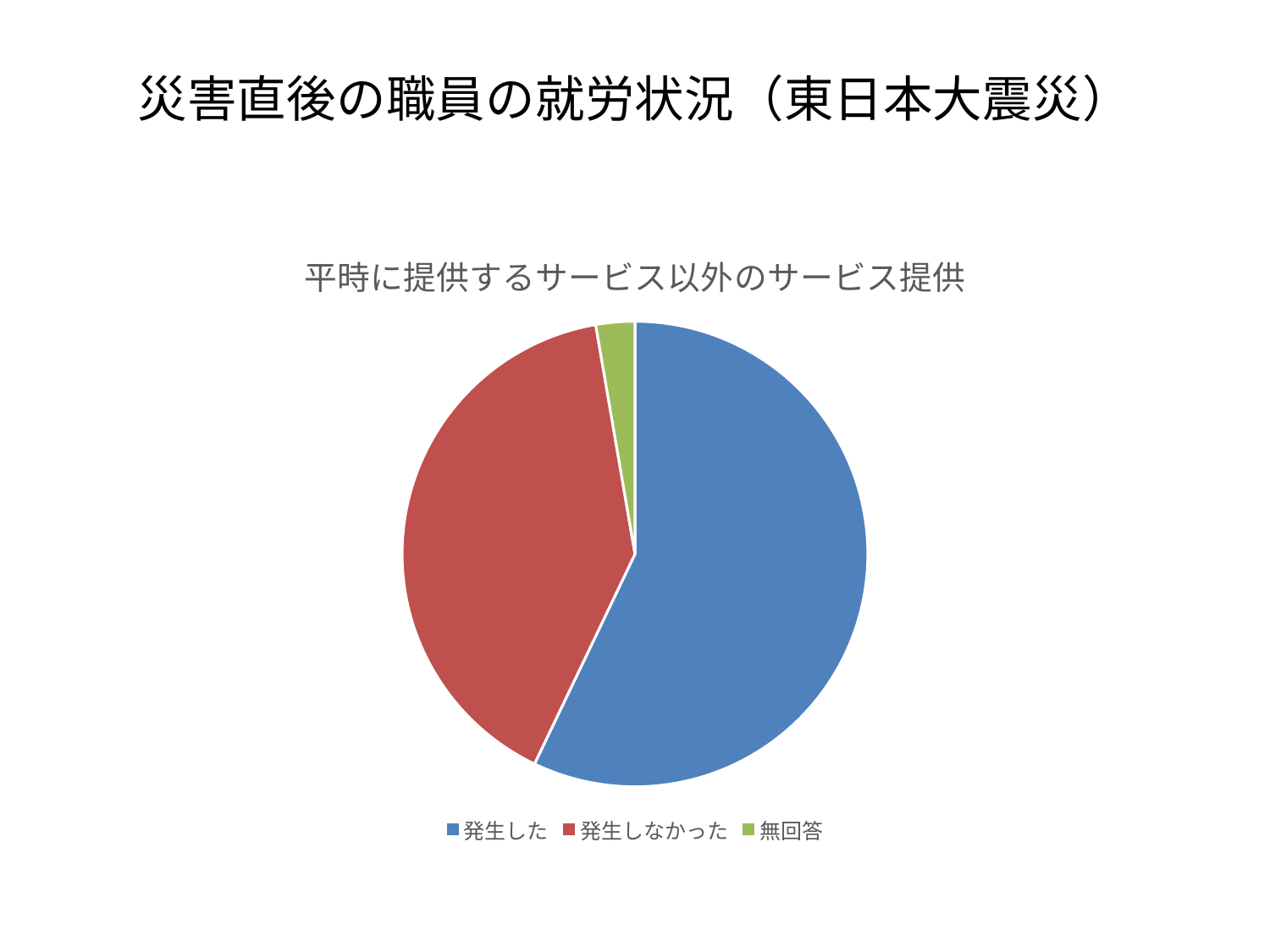
What kind of chart is shown on the slide? pie chart How many entries does the legend of the pie chart list? 3 Which slice is larger, 発生した or 発生しなかった? 発生した What is the title of the pie chart? 平時に提供するサービス以外のサービス提供 Which category has the smallest slice in the pie chart? 無回答 Which category has the largest slice in the pie chart? 発生した How many slices does the pie chart have? 3 What colour is the 無回答 slice in the pie chart? green Which slice is larger, 発生しなかった or 無回答? 発生しなかった Does the 発生した slice take up more or less than half of the pie? more